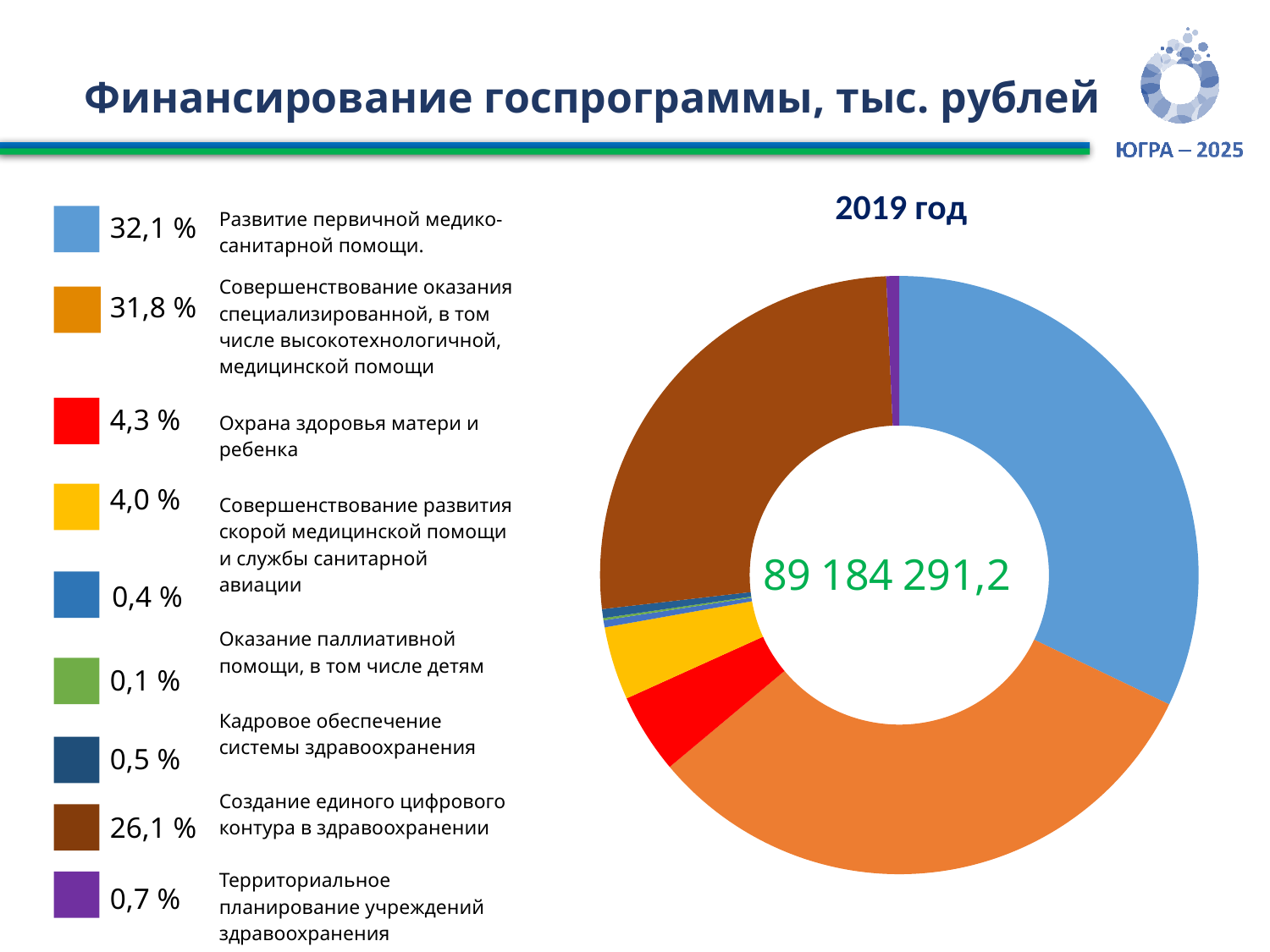
What year does the doughnut chart refer to, according to its title? 2019 год Which category has the largest share in the chart? Развитие первичной медико-санитарной помощи (32,1 %) What kind of chart is shown on the slide? Doughnut (pie) chart What share of the chart is 'Охрана здоровья матери и ребенка'? 4,3 % What is the smallest share shown in the legend? 0,1 % What share of the chart is 'Развитие первичной медико-санитарной помощи'? 32,1 % How many slices does the doughnut chart have? 9 What total value is printed in the centre of the doughnut chart? 89 184 291,2 What is the difference in percentage points between the 32,1 % slice and the 31,8 % slice? 0,3